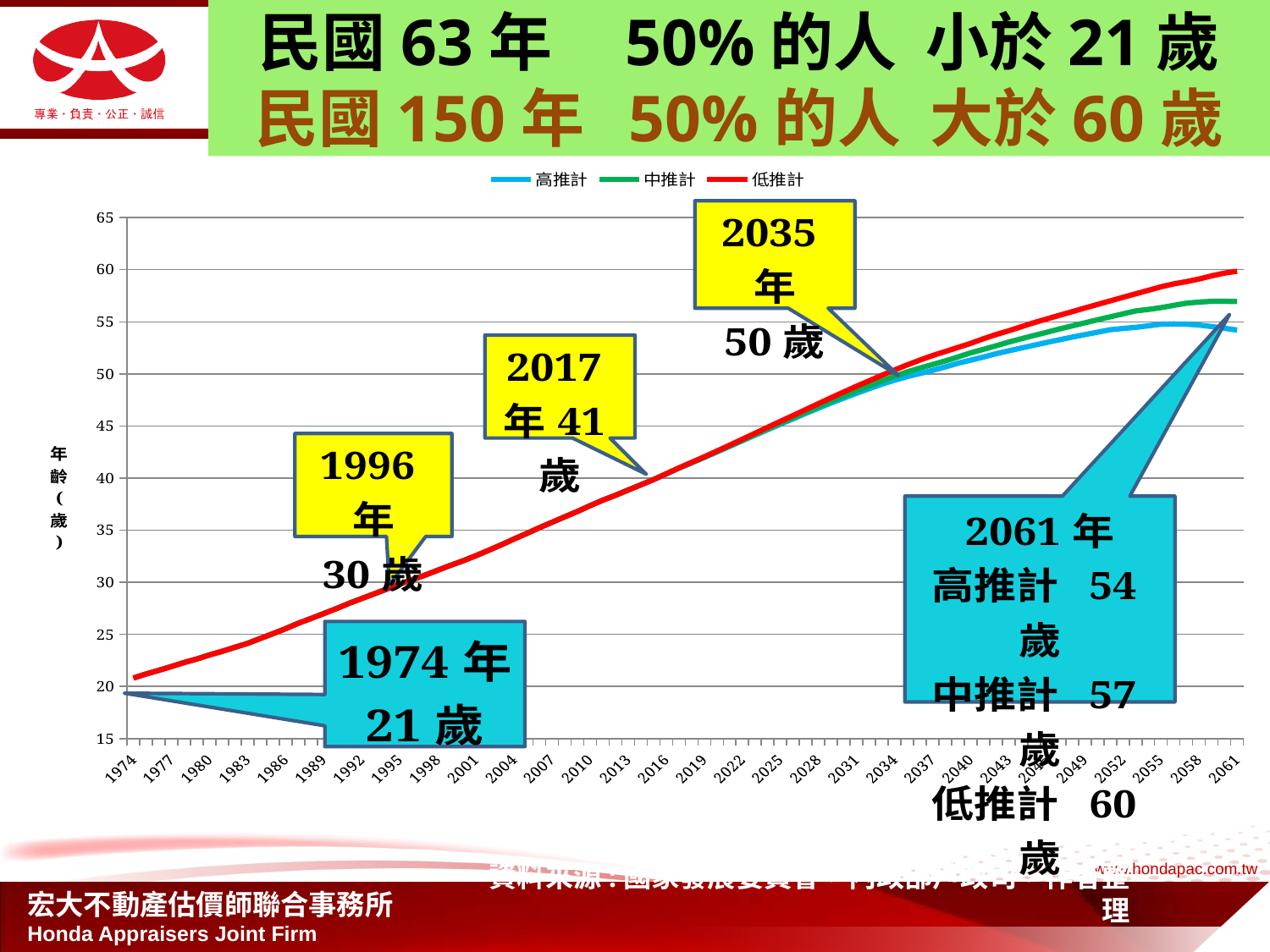
What is the 低推計 value for 2061? 60 歲 According to the callout, what is the median age in 1996? 30 歲 In 2061, how much higher is 低推計 than 高推計? 6 歲 Do the values rise or fall from 1974 to 2061? rise According to the callout, what is the median age in 1974? 21 歲 According to the callout, what is the median age in 2035? 50 歲 What kind of chart is shown on the slide? line chart How many series does the legend list? 3 What is the 高推計 value for 2061? 54 歲 Which series has the highest value in 2061? 低推計 Is the value for 1980 greater or less than 25? less According to the callout, what is the median age in 2017? 41 歲